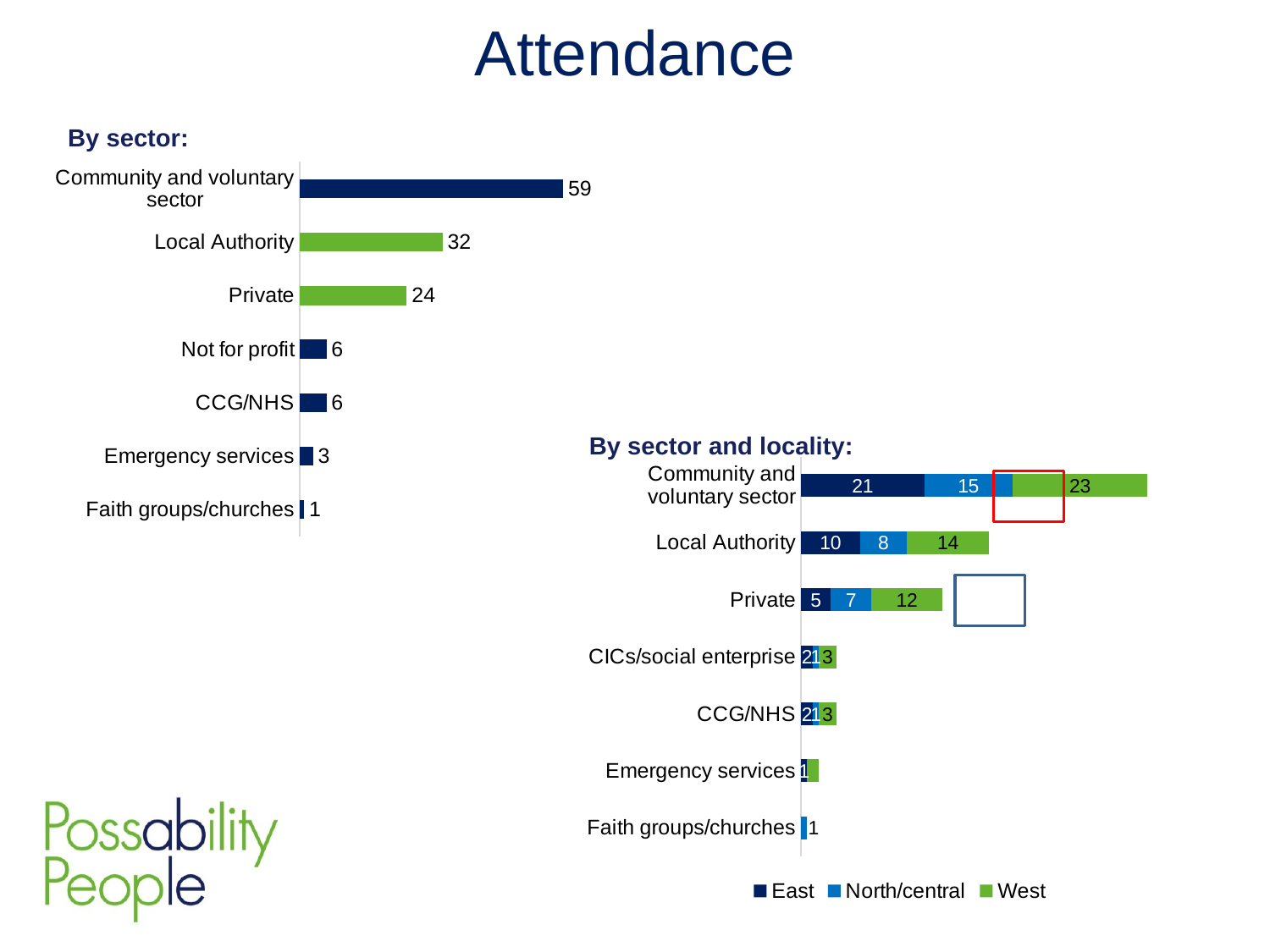
In the 'By sector' chart, what is the value for Emergency services? 3 In the 'By sector' chart, how many sectors are shown? 7 In the 'By sector and locality' chart, what is the total for the Private bar? 24 In the 'By sector and locality' chart, which is larger for Private: East or North/central? North/central In the 'By sector and locality' chart, what is the West value for Local Authority? 14 In the 'By sector and locality' chart, what is the North/central value for Community and voluntary sector? 15 In the 'By sector and locality' chart, how many series does the legend list? 3 In the 'By sector' chart, which sector has the highest attendance? Community and voluntary sector What kind of chart is the 'By sector and locality' chart? Stacked bar chart In the 'By sector' chart, which sector has the lowest attendance? Faith groups/churches In the 'By sector' chart, what is the difference between Community and voluntary sector and Local Authority? 27 In the 'By sector' chart, what is the value for Local Authority? 32